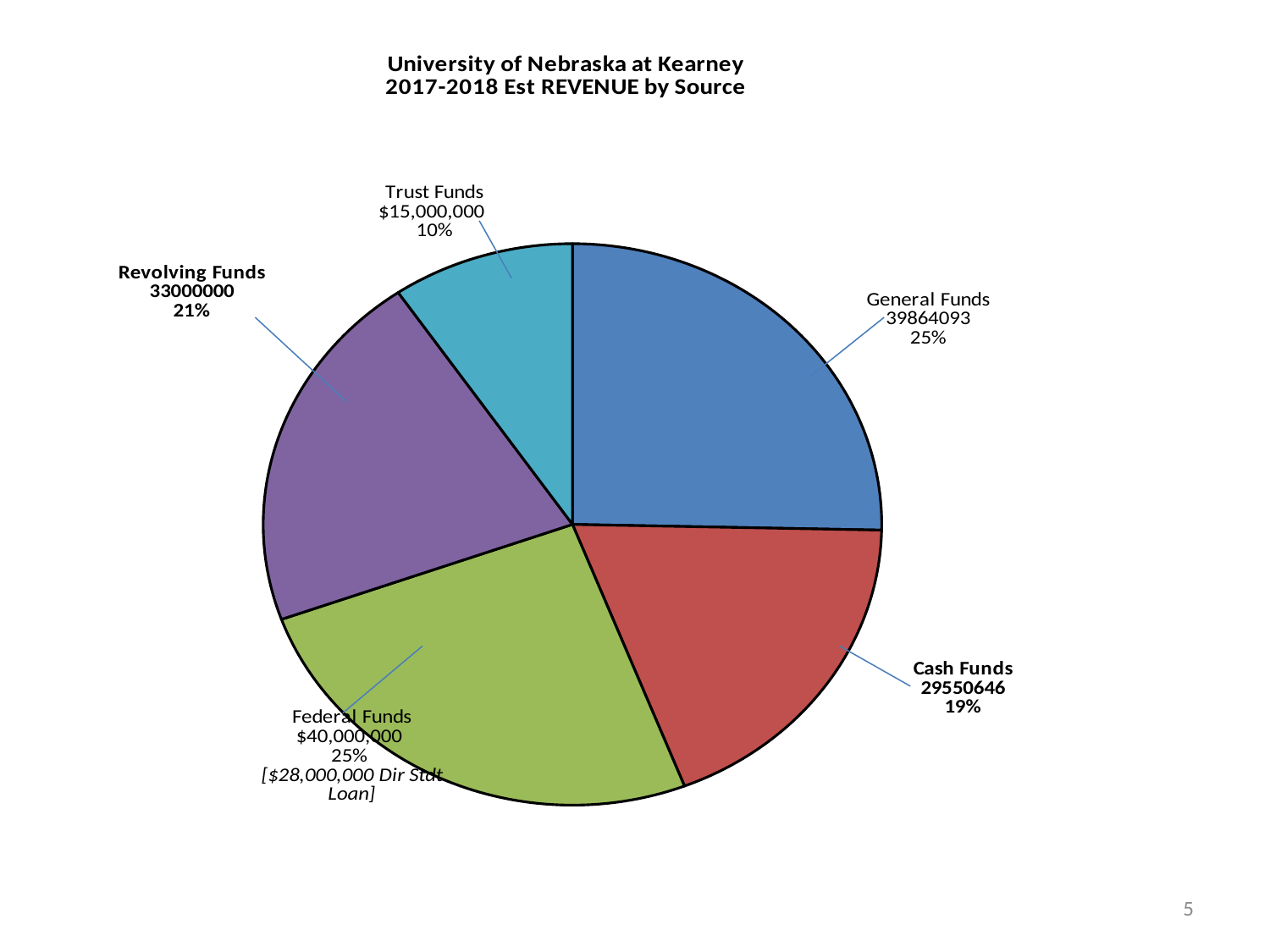
What is the title of the chart? University of Nebraska at Kearney 2017-2018 Est REVENUE by Source How many revenue sources (slices) does the pie chart show? 5 What is the difference between the Federal Funds value and the Trust Funds value? $25,000,000 Which revenue source has the smallest slice? Trust Funds What is the value shown for General Funds? 39864093 What type of chart is shown on the slide? pie chart What share of the pie does Trust Funds represent? 10% What is the value shown for Revolving Funds? 33000000 What share of the pie does Cash Funds represent? 19% What is the value shown for Cash Funds? 29550646 What is the value shown for Trust Funds? $15,000,000 Which is larger, Revolving Funds or Cash Funds? Revolving Funds